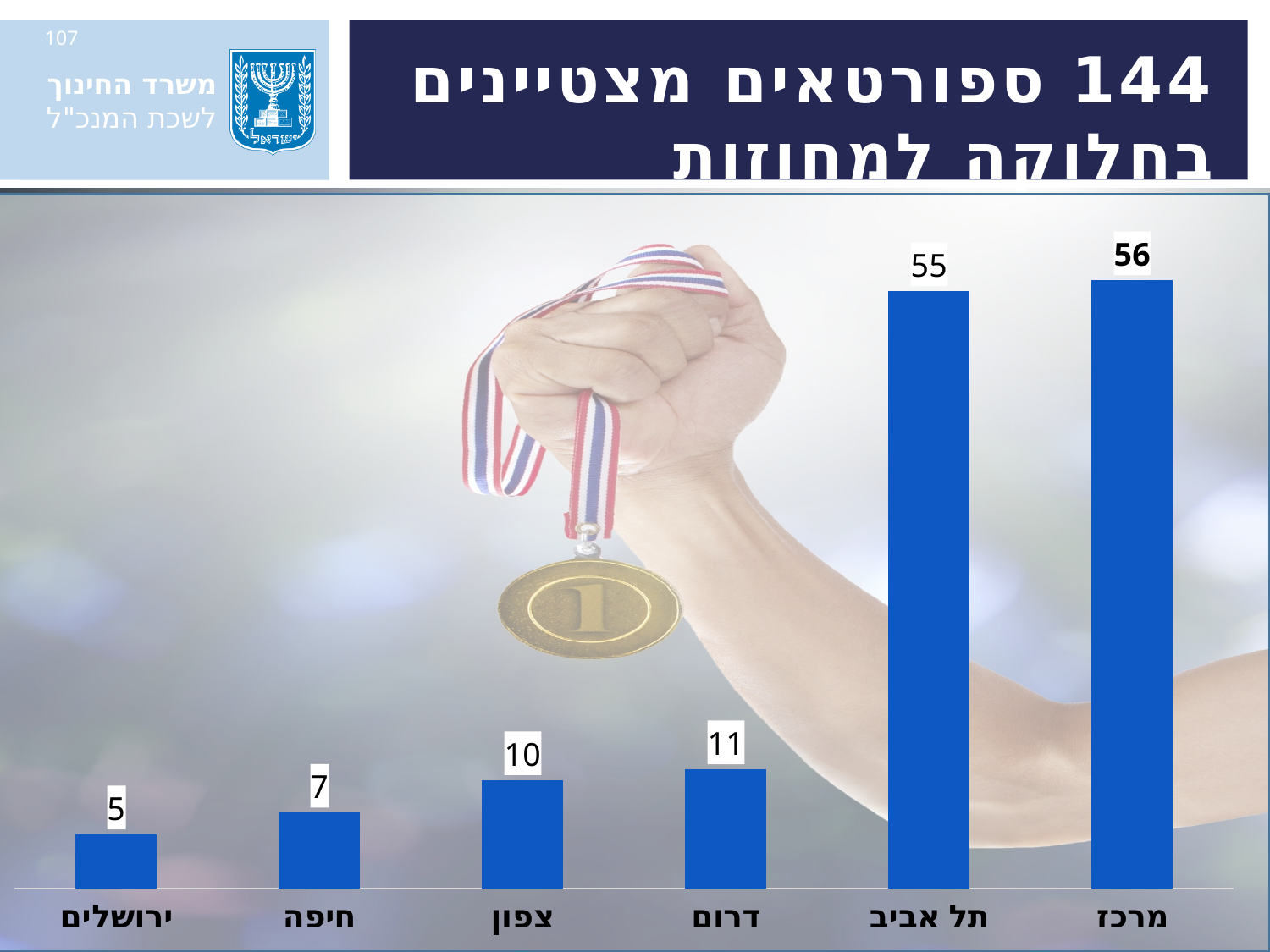
What is the difference between the values for מרכז and תל אביב? 1 What kind of chart is shown on the slide? bar chart What is the difference between the values for דרום and חיפה? 4 What is the total of the values for ירושלים, חיפה, צפון and דרום? 33 What is the value for ירושלים? 5 Which district has the lowest value? ירושלים Which is larger, the value for צפון or the value for חיפה? צפון What is the title of the slide? 144 ספורטאים מצטיינים בחלוקה למחוזות Which district has the highest value? מרכז What is the value for דרום? 11 How many districts are shown in the chart? 6 What is the value for תל אביב? 55